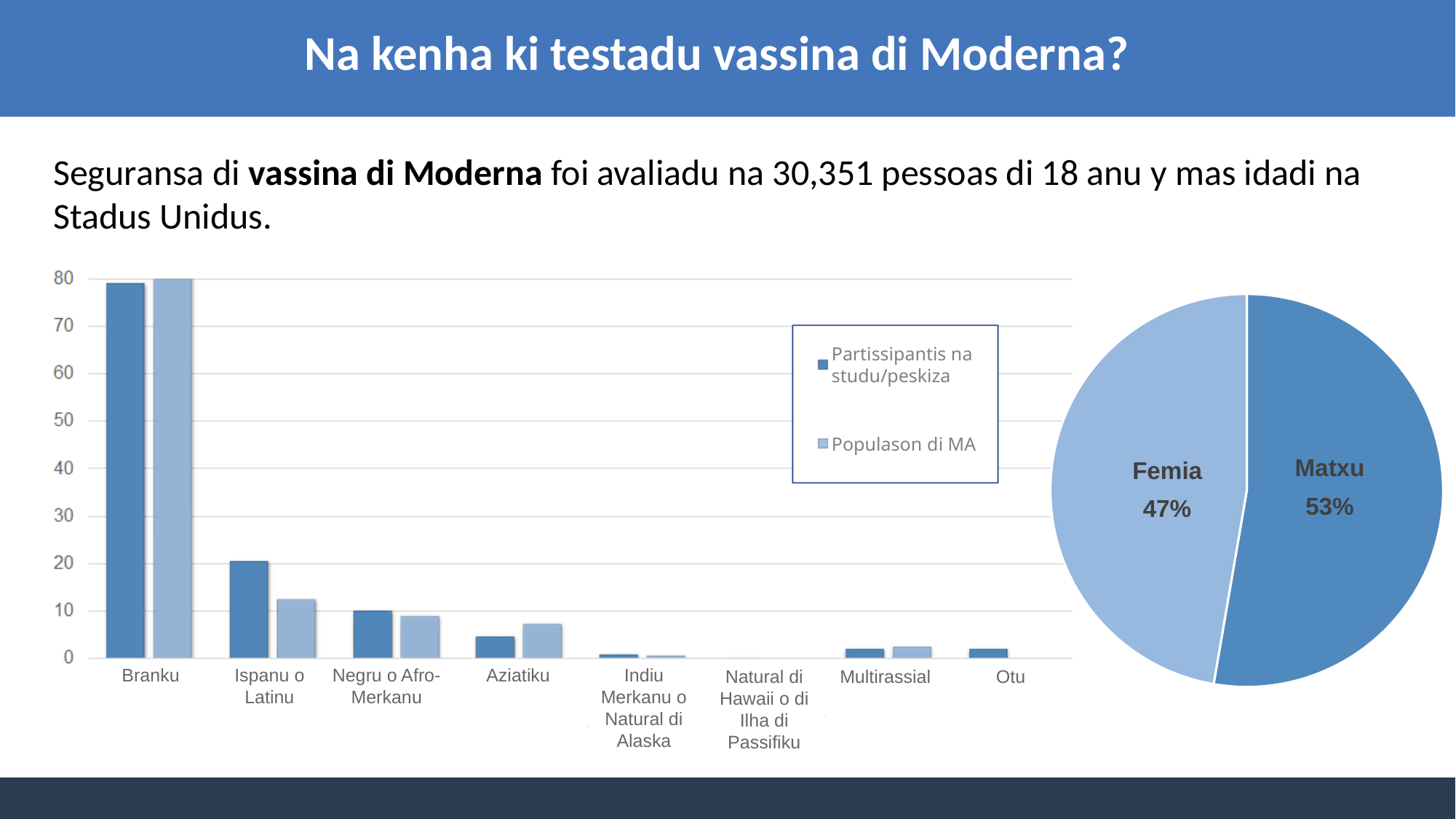
In the bar chart on the left, for Ispanu o Latinu, which series has the larger value, Partissipantis na studu/peskiza or Populason di MA? Partissipantis na studu/peskiza In the bar chart on the left, is the Partissipantis na studu/peskiza value for Branku greater or less than 70? greater In the pie chart on the right, what is the difference in percentage points between Matxu and Femia? 6 percentage points In the pie chart on the right, how many slices are there? 2 In the bar chart on the left, how many series does the legend list? 2 In the pie chart on the right, what share is labelled for Matxu? 53% In the bar chart on the left, is the Partissipantis na studu/peskiza value for Aziatiku greater or less than 10? less In the pie chart on the right, which slice is larger, Femia or Matxu? Matxu What kind of chart is the chart on the left of the slide? Bar chart In the bar chart on the left, how many categories are shown on the x axis? 8 In the bar chart on the left, which category has the highest value for Partissipantis na studu/peskiza? Branku In the pie chart on the right, what share is labelled for Femia? 47%